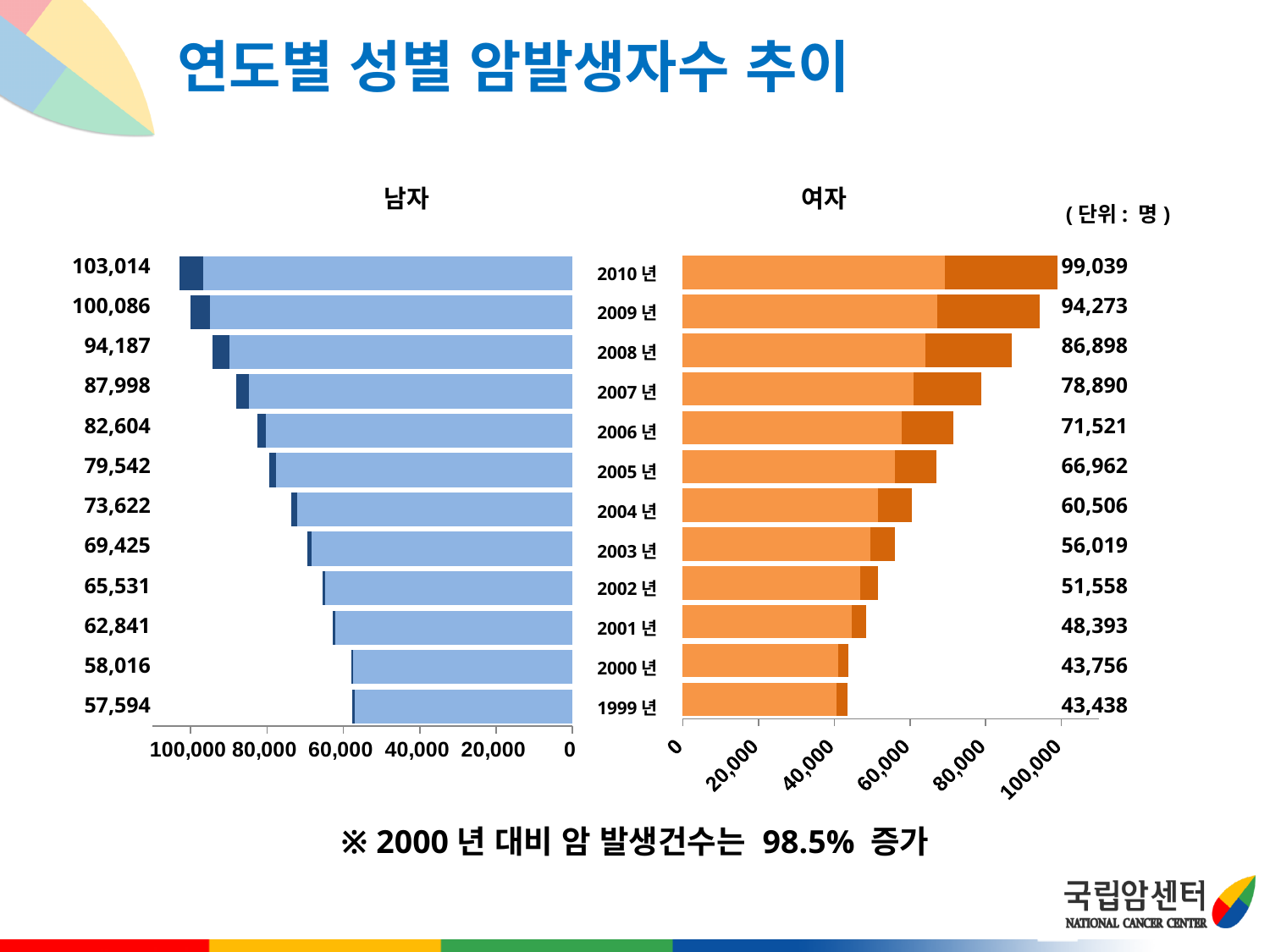
On the 여자 (female) side of the chart, what is the value for 2000년? 43,756 How many years are shown in the chart? 12 On the 여자 (female) side of the chart, what is the value for 2005년? 66,962 On the 여자 (female) side of the chart, which year has the highest value? 2010년 On the 여자 (female) side of the chart, how much higher is the 2010년 value than the 1999년 value? 55,601 What is the difference between the 남자 (male) value and the 여자 (female) value for 2010년? 3,975 For 2008년, which is larger: the 남자 (male) value or the 여자 (female) value? 남자 (male) On the 남자 (male) side of the chart, what is the value for 2010년? 103,014 What kind of chart is shown on the slide? Bar chart On the 여자 (female) side of the chart, do the values rise or fall from 1999년 to 2010년? Rise On the 남자 (male) side of the chart, which year has the lowest value? 1999년 On the 남자 (male) side of the chart, what is the value for 1999년? 57,594